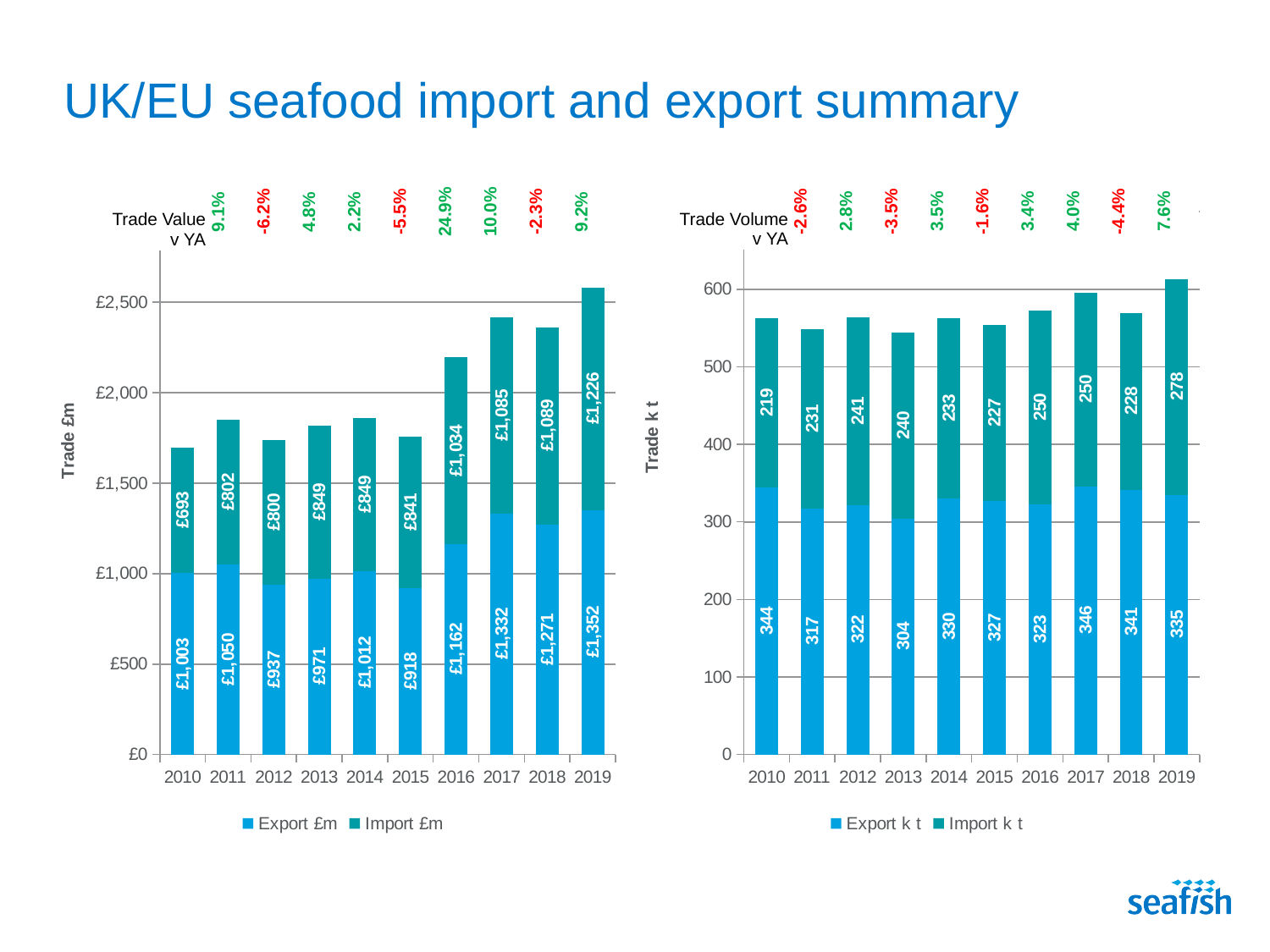
In the Trade Value chart on the left, what is the Import £m value for 2016? £1,034 In the Trade Value chart on the left, what is the Export £m value for 2019? £1,352 In the Trade Volume chart on the right, which is larger: the Export k t value for 2010 or for 2011? 2010 In the Trade Volume chart on the right, what is the total of the stacked bar for 2019? 613 In the Trade Value chart on the left, what is the difference between the Export £m values for 2019 and 2018? £81 What kind of chart is the Trade Volume chart on the right? Stacked bar chart How many years are shown on the x axis of the Trade Volume chart on the right? 10 In the Trade Volume chart on the right, what is the Import k t value for 2019? 278 In the Trade Value chart on the left, which year has the highest Import £m value? 2019 In the Trade Volume chart on the right, which year has the lowest Export k t value? 2013 In the Trade Value chart on the left, is the total stacked bar for 2019 greater or less than £2,500? greater How many series does the legend of the Trade Value chart on the left list? 2